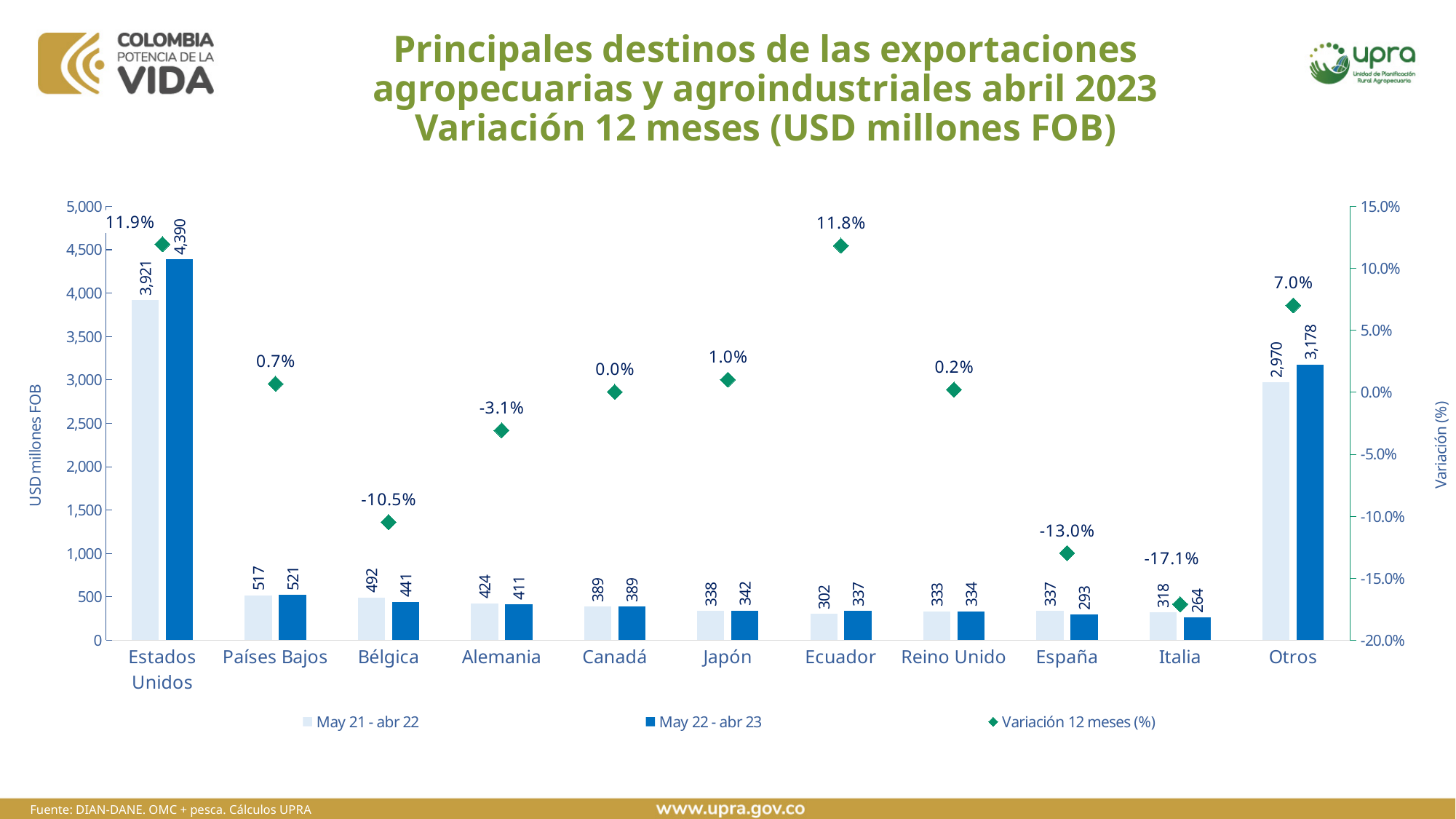
What is the difference between the May 22 - abr 23 and May 21 - abr 22 values for Estados Unidos? 469 How many series does the legend list? 3 What is the Variación 12 meses (%) value for Ecuador? 11.8% Which category has the lowest value in the May 22 - abr 23 series? Italia How many categories are shown on the x axis? 11 What is the Variación 12 meses (%) value for Italia? -17.1% What is the label of the left vertical axis? USD millones FOB Which is larger for España: the May 21 - abr 22 value or the May 22 - abr 23 value? May 21 - abr 22 What is the value for Estados Unidos in the May 22 - abr 23 series? 4,390 What is the value for Bélgica in the May 21 - abr 22 series? 492 Which country has the highest value in the May 22 - abr 23 series? Estados Unidos Is the May 22 - abr 23 value for Otros greater or less than 3,000? greater